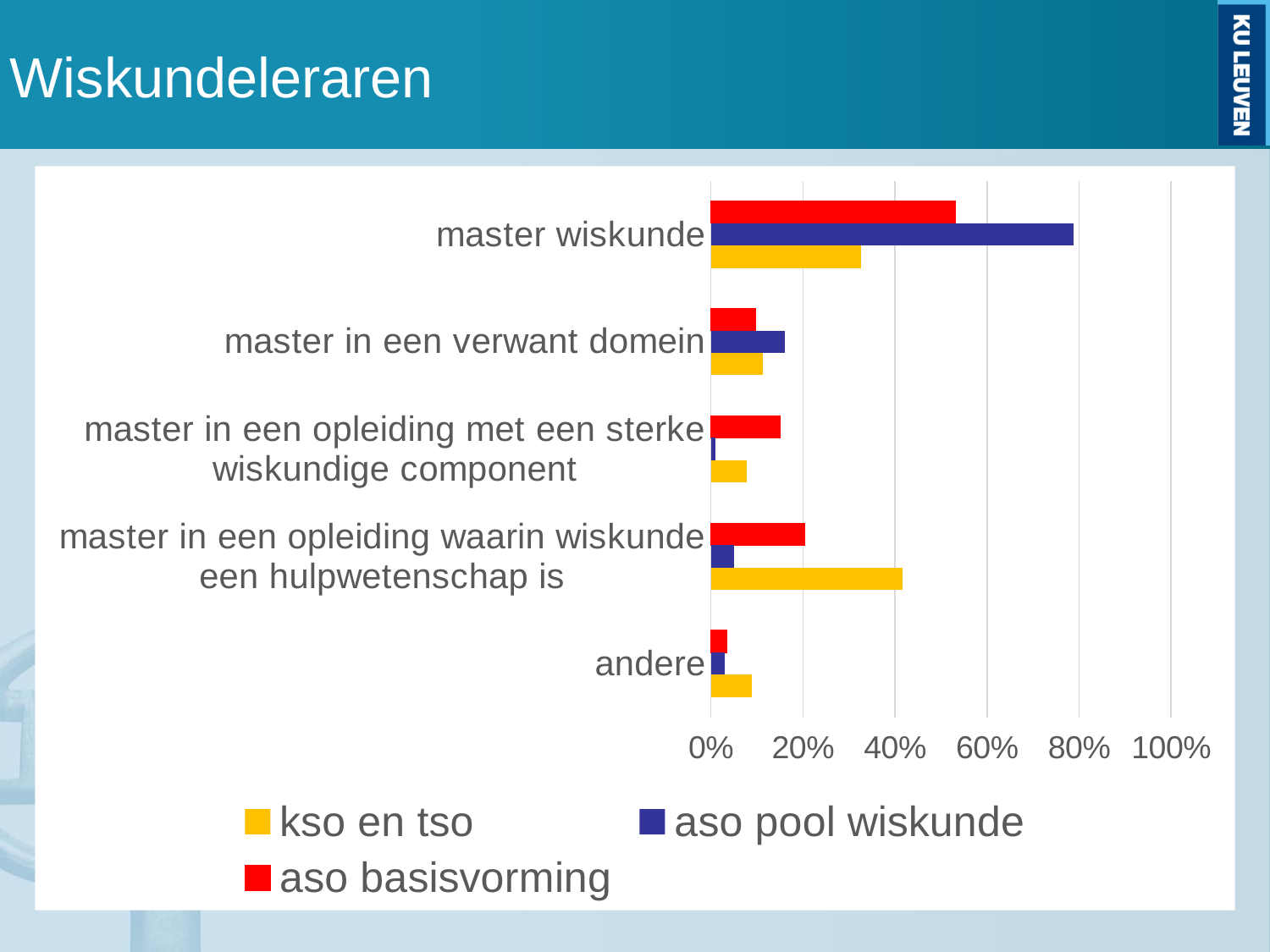
Is the value for 'aso pool wiskunde' in the 'master wiskunde' category greater or less than 60%? greater In the 'master in een opleiding waarin wiskunde een hulpwetenschap is' category, which series has the larger value: 'kso en tso' or 'aso pool wiskunde'? kso en tso Which colour represents the 'aso basisvorming' series in the chart? red How many series does the legend list? 3 What kind of chart is shown on the slide? bar chart Is the value for 'kso en tso' in the 'master in een opleiding waarin wiskunde een hulpwetenschap is' category greater or less than 20%? greater Which category has the highest value for the 'aso pool wiskunde' series? master wiskunde Which category has the highest value for the 'kso en tso' series? master in een opleiding waarin wiskunde een hulpwetenschap is How many categories are shown on the vertical axis of the chart? 5 In the 'master wiskunde' category, which series has the larger value: 'aso pool wiskunde' or 'aso basisvorming'? aso pool wiskunde Is the value for 'kso en tso' in the 'master wiskunde' category greater or less than 40%? less